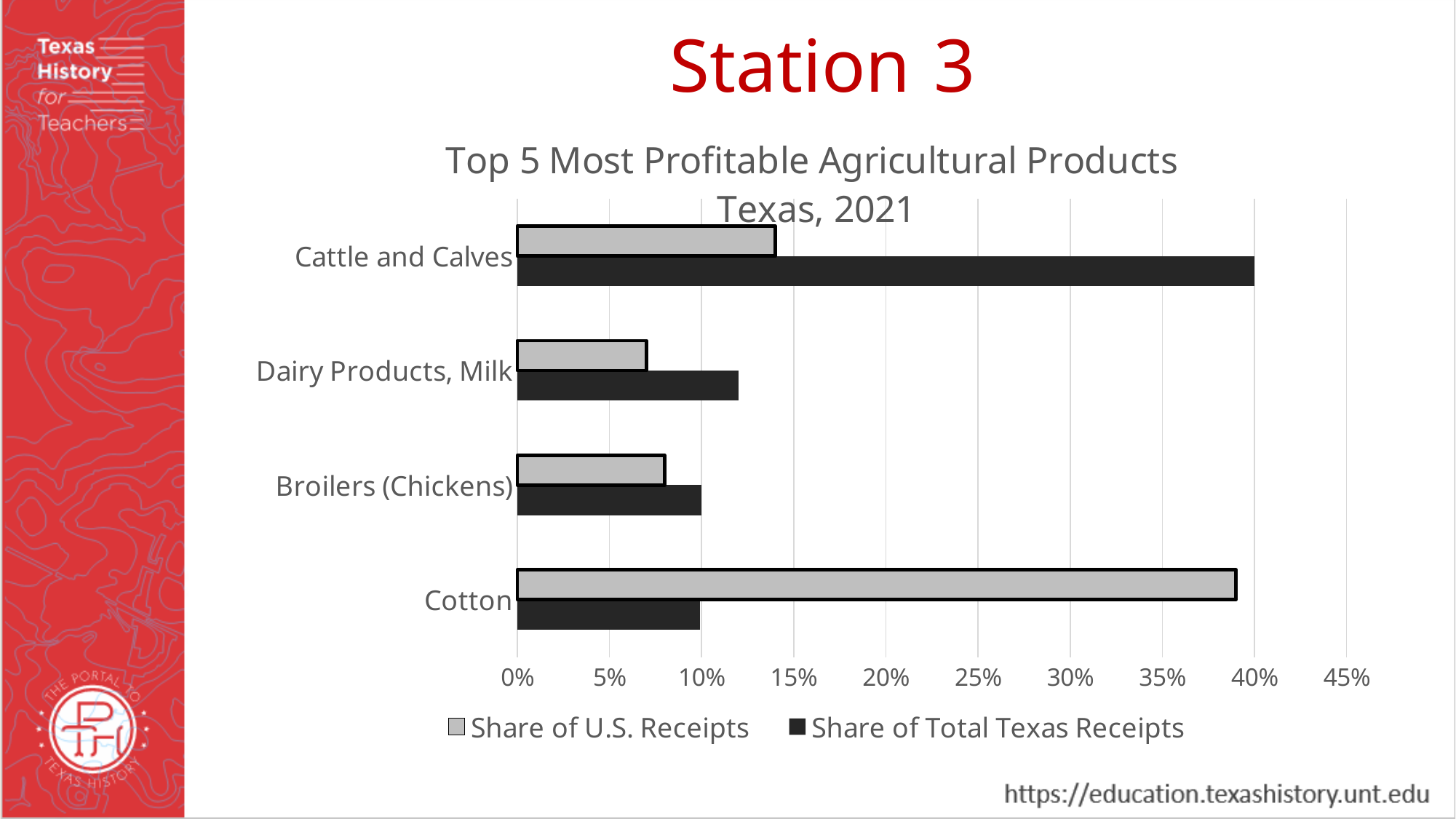
What kind of chart is shown on the slide? bar chart What is the title of the chart? Top 5 Most Profitable Agricultural Products Texas, 2021 Is the Share of U.S. Receipts for Cotton greater or less than 35%? greater What is the Share of Total Texas Receipts for Broilers (Chickens)? 10% Is the Share of U.S. Receipts for Cattle and Calves greater or less than 10%? greater For Cotton, which is larger: the Share of U.S. Receipts or the Share of Total Texas Receipts? Share of U.S. Receipts How many series does the legend list? 2 Which category has the highest Share of Total Texas Receipts? Cattle and Calves How many product categories are plotted on the chart? 4 What is the Share of Total Texas Receipts for Cattle and Calves? 40% Which category has the highest Share of U.S. Receipts? Cotton Is the Share of U.S. Receipts for Dairy Products, Milk greater or less than 10%? less